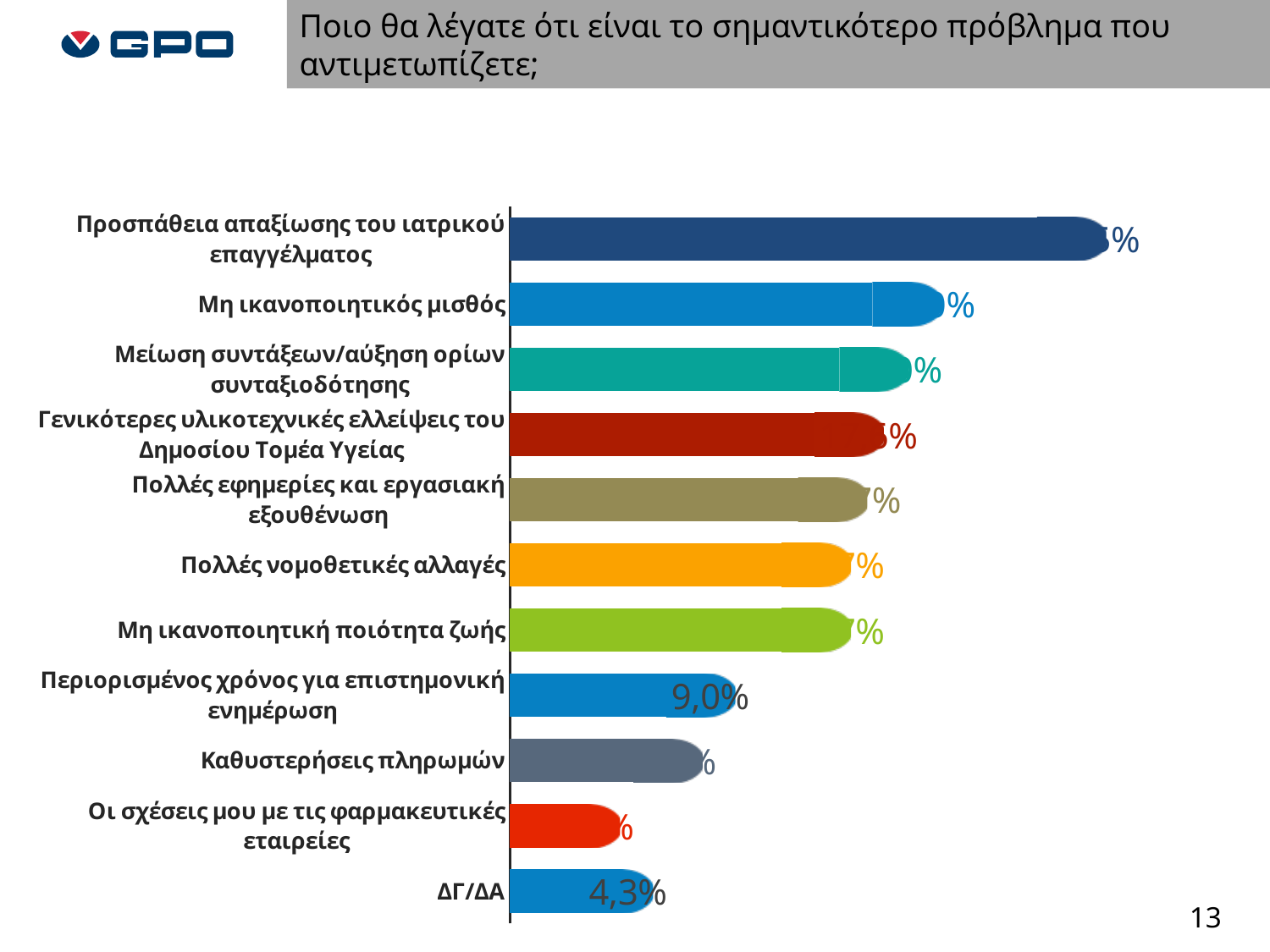
Which category has the highest value in the chart? Προσπάθεια απαξίωσης του ιατρικού επαγγέλματος What is the value for 'ΔΓ/ΔΑ'? 4,3% What is the title of the slide containing the chart? Ποιο θα λέγατε ότι είναι το σημαντικότερο πρόβλημα που αντιμετωπίζετε; What kind of chart is shown on the slide? bar chart Which is larger: the value for 'Μη ικανοποιητικός μισθός' or the value for 'Καθυστερήσεις πληρωμών'? Μη ικανοποιητικός μισθός What is the difference between the values for 'Περιορισμένος χρόνος για επιστημονική ενημέρωση' and 'ΔΓ/ΔΑ'? 4,7% What is the value for 'Περιορισμένος χρόνος για επιστημονική ενημέρωση'? 9,0% Which is larger: the value for 'Οι σχέσεις μου με τις φαρμακευτικές εταιρείες' or the value for 'Πολλές νομοθετικές αλλαγές'? Πολλές νομοθετικές αλλαγές Which is larger: the value for 'Μείωση συντάξεων/αύξηση ορίων συνταξιοδότησης' or the value for 'Μη ικανοποιητική ποιότητα ζωής'? Μείωση συντάξεων/αύξηση ορίων συνταξιοδότησης Which category has the lowest value in the chart? Οι σχέσεις μου με τις φαρμακευτικές εταιρείες How many categories (bars) does the chart show? 11